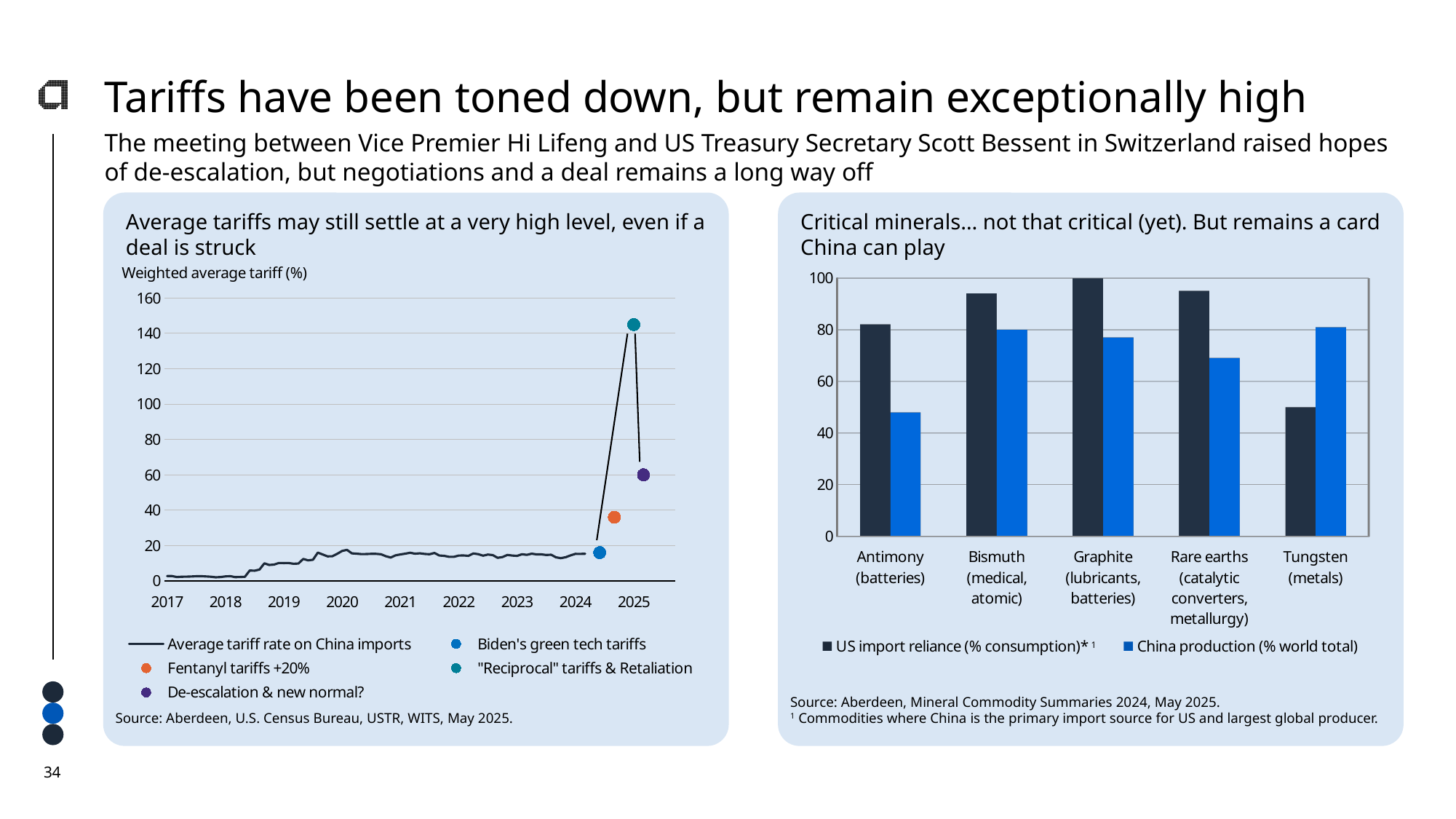
On the left chart, does the average tariff rate on China imports rise or fall between 2017 and 2024? rise On the right chart, which mineral has the highest US import reliance? Graphite On the right chart, how many minerals are shown on the x axis? 5 On the right chart, which mineral has the lowest China production (% world total)? Antimony On the right chart, which mineral has the lowest US import reliance? Tungsten On the left chart, how many entries does the legend list? 5 On the left chart, is the value for the "Reciprocal" tariffs & Retaliation point greater or less than 140? greater On the right chart, how many series does the legend list? 2 On the left chart, is the value for the Fentanyl tariffs +20% point greater or less than 40? less On the left chart, is the value for Biden's green tech tariffs greater or less than 20? less On the left chart, what kind of chart is used to show the average tariff rate on China imports? line chart On the right chart, for Tungsten, which is larger: US import reliance or China production? China production